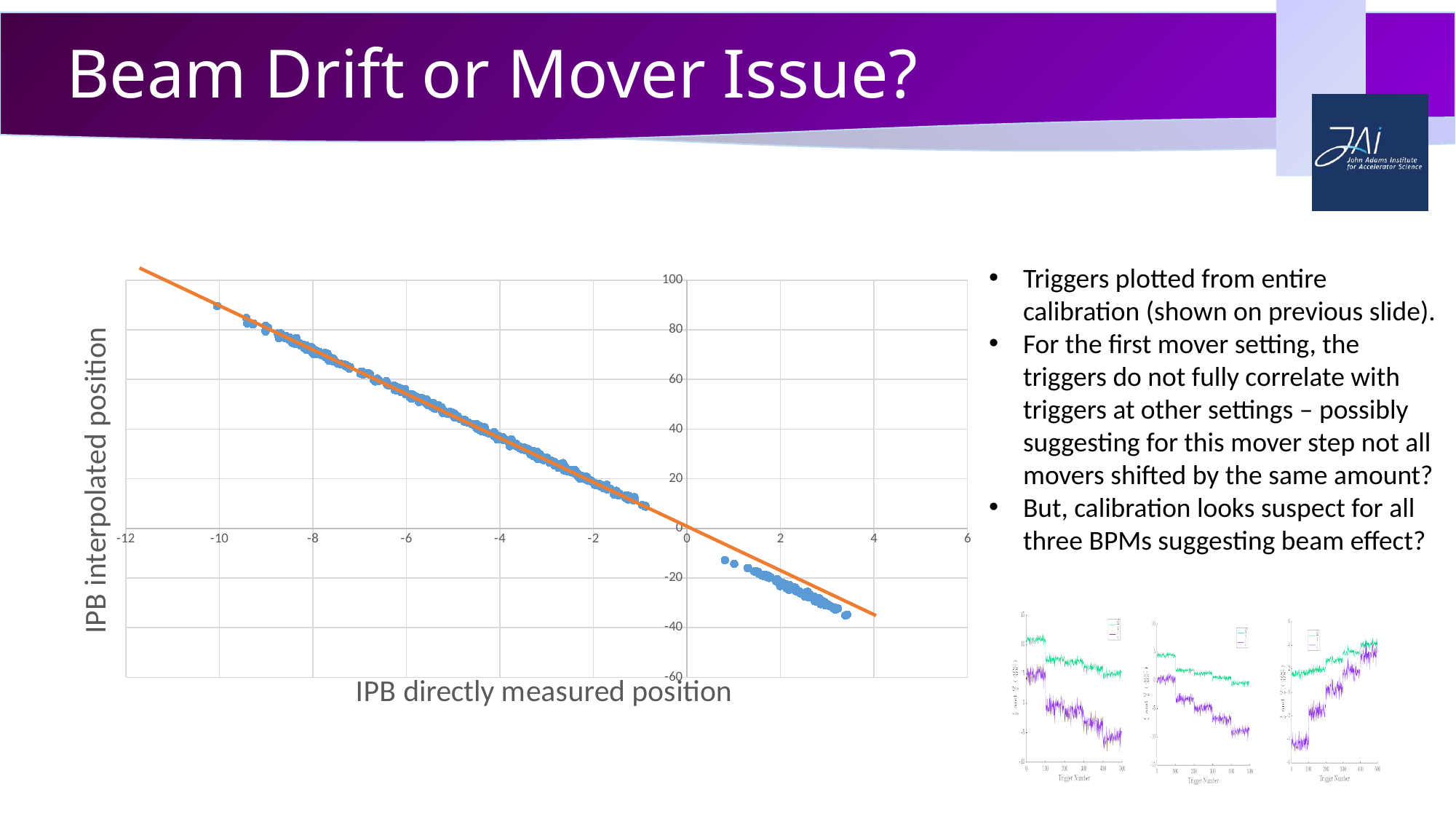
What is the title of the y axis of the main chart? IPB interpolated position In the main chart, do the plotted values rise or fall as the directly measured position increases along the x axis? fall What is the title of the x axis of the main chart? IPB directly measured position In the main chart, is the interpolated position for a directly measured position of -10 greater or less than 80? greater What kind of chart is the main chart on the slide? scatter chart In the main chart, which has the higher interpolated position: the points near a directly measured position of -8 or those near 2? the points near -8 In the main chart, is the interpolated position for a directly measured position of 3 greater or less than -20? less What is the highest value shown on the y axis of the main chart? 100 In the main chart, is the interpolated position for a directly measured position of -6 greater or less than 40? greater